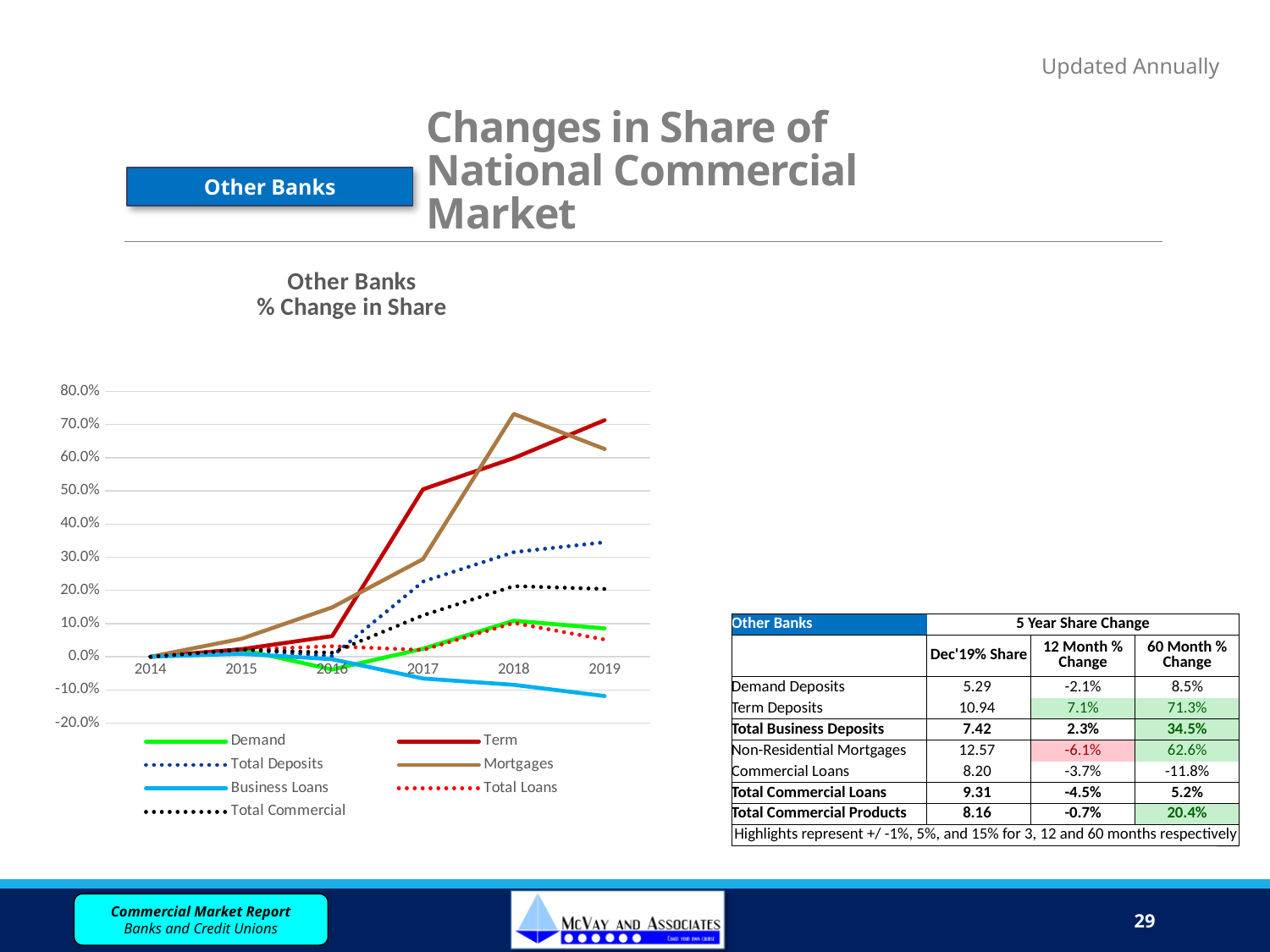
What is the title of the chart? Other Banks % Change in Share Is the value for Term in 2019 greater or less than 60.0%? greater Is the value for Total Deposits in 2019 greater or less than 30.0%? greater Is the value for Business Loans in 2019 greater or less than 0.0%? less In 2019, which is larger: the value for Total Deposits or the value for Total Commercial? Total Deposits Which series has the highest value in 2018? Mortgages What kind of chart is shown on the slide? line chart How many years are shown along the x axis of the chart? 6 How many series does the chart's legend list? 7 Which series has the highest value in 2019? Term Does the Term series rise or fall from 2014 to 2019? rise Which series has the lowest value in 2019? Business Loans